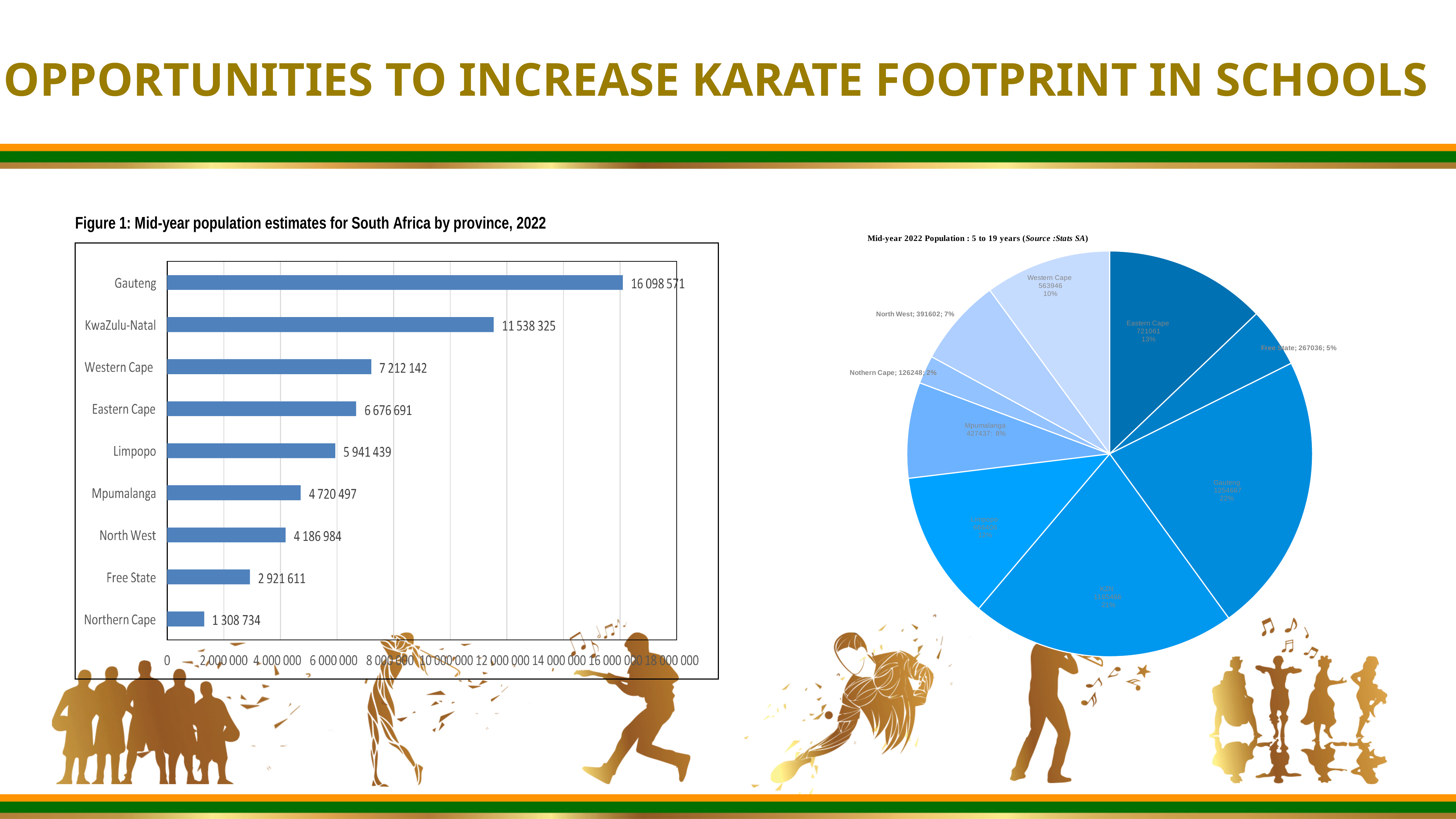
In the pie chart on the right, what is the value shown for North West? 391602 In the pie chart on the right, what percentage share does Eastern Cape have? 13% What type of chart is Figure 1 on the left of the slide? Bar chart In the bar chart (Figure 1), what is the difference between the populations of Gauteng and KwaZulu-Natal? 4 560 246 In the bar chart (Figure 1), what is the population value shown for Free State? 2 921 611 What is the title of the pie chart on the right of the slide? Mid-year 2022 Population : 5 to 19 years (Source :Stats SA) In the pie chart on the right, what percentage share does Western Cape have? 10% In the bar chart (Figure 1), how many provinces are shown? 9 In the bar chart (Figure 1), what is the mid-year population estimate for Gauteng? 16 098 571 In the bar chart (Figure 1), which has a larger population, Western Cape or Eastern Cape? Western Cape In the bar chart (Figure 1), which province has the highest population? Gauteng In the bar chart (Figure 1), which province has the lowest population? Northern Cape